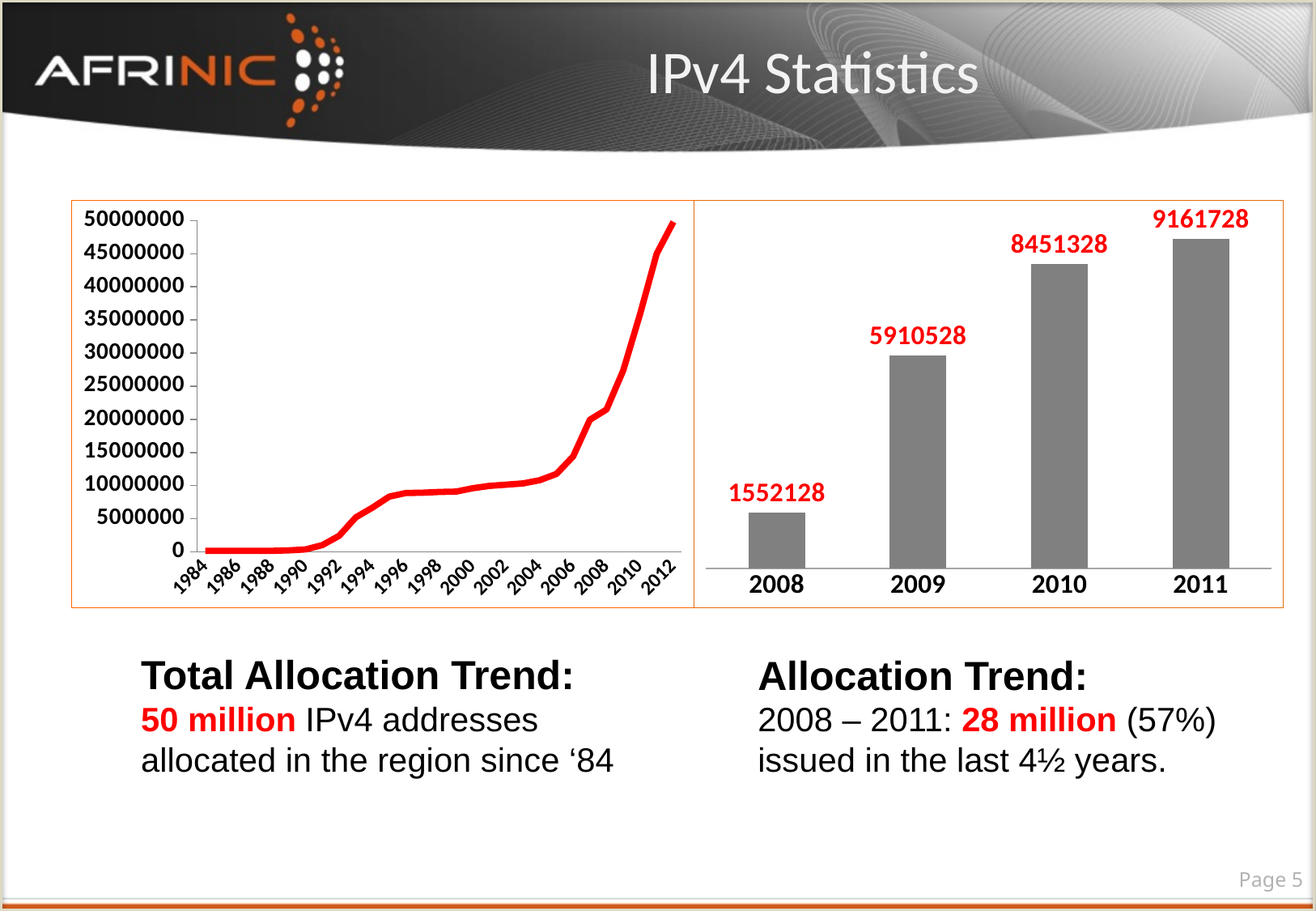
In the bar chart on the right, what is the value for 2011? 9161728 In the bar chart on the right, which year has the lowest value? 2008 In the bar chart on the right, what is the value for 2008? 1552128 How many bars are in the bar chart on the right? 4 In the line chart on the left, do the values rise or fall from 1984 to 2012? rise In the line chart on the left, is the value for 2012 greater or less than 45000000? greater In the bar chart on the right, which is larger, the value for 2009 or the value for 2010? 2010 In the bar chart on the right, what is the value for 2009? 5910528 In the bar chart on the right, what is the difference between the values for 2011 and 2010? 710400 In the bar chart on the right, what is the difference between the values for 2009 and 2008? 4358400 What kind of chart is the chart on the left? line chart In the bar chart on the right, which year has the highest value? 2011